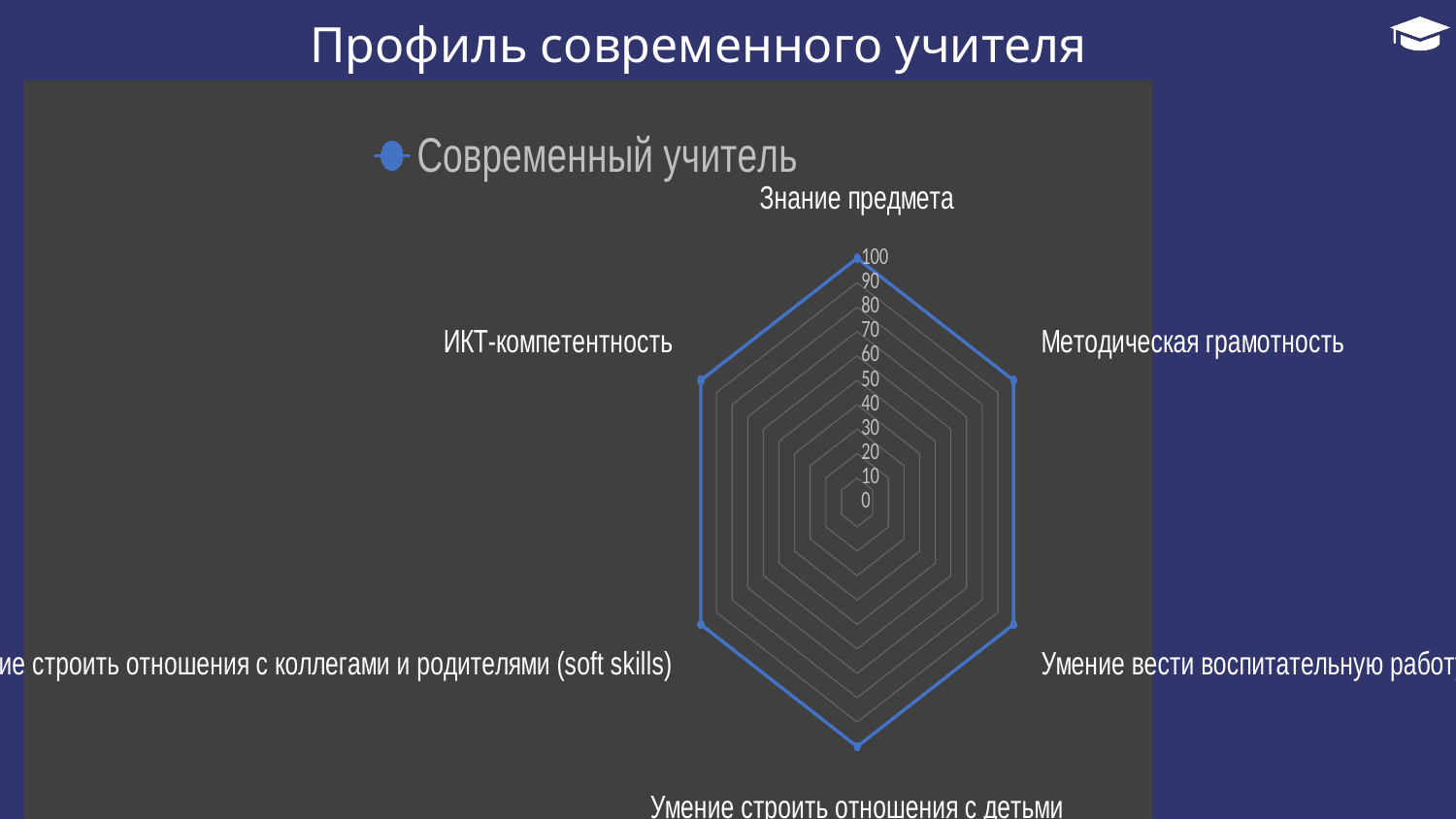
Is the value for ИКТ-компетентность greater or less than 50? greater How many categories (axes) does the radar chart have? 6 What is the name of the series shown in the legend? Современный учитель How many series does the legend list? 1 Is the value for Знание предмета greater or less than 90? greater What kind of chart is shown on the slide? Radar chart What is the maximum value shown on the chart's axis scale? 100 What is the value for Знание предмета? 100 Is the value for Умение строить отношения с детьми greater or less than 80? greater